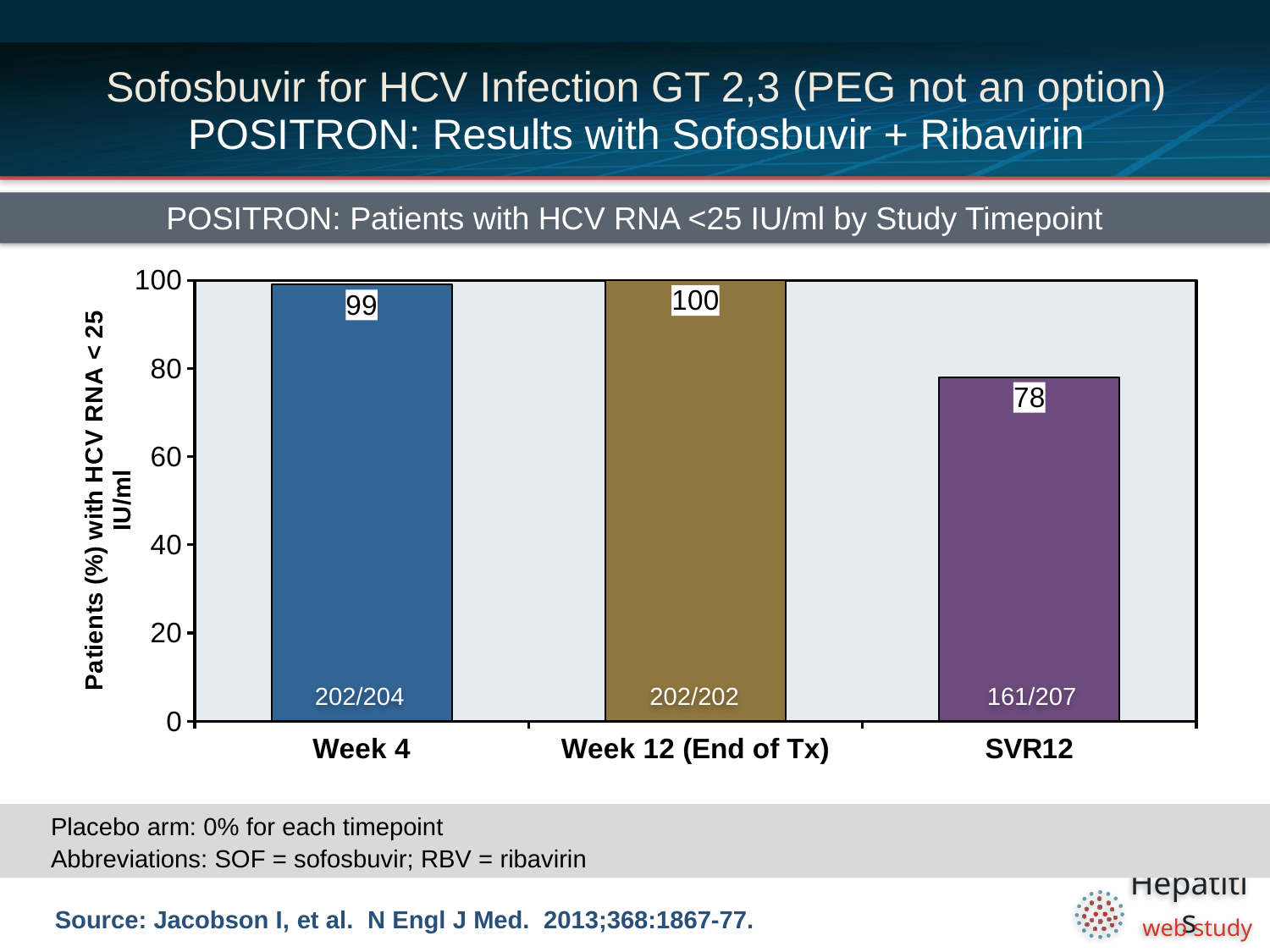
What is the value for Week 12 (End of Tx)? 100 What is the difference between the Week 12 (End of Tx) value and the SVR12 value? 22 Which timepoint has the lowest value? SVR12 Which timepoint has the highest value? Week 12 (End of Tx) What kind of chart is shown? bar chart What is the value for Week 4? 99 How many timepoints are shown on the x axis? 3 Which is larger, the value for Week 4 or the value for SVR12? Week 4 What fraction of patients is printed inside the SVR12 bar? 161/207 What is the value for SVR12? 78 Is the value for SVR12 greater or less than 80? less What is the difference between the Week 4 value and the SVR12 value? 21